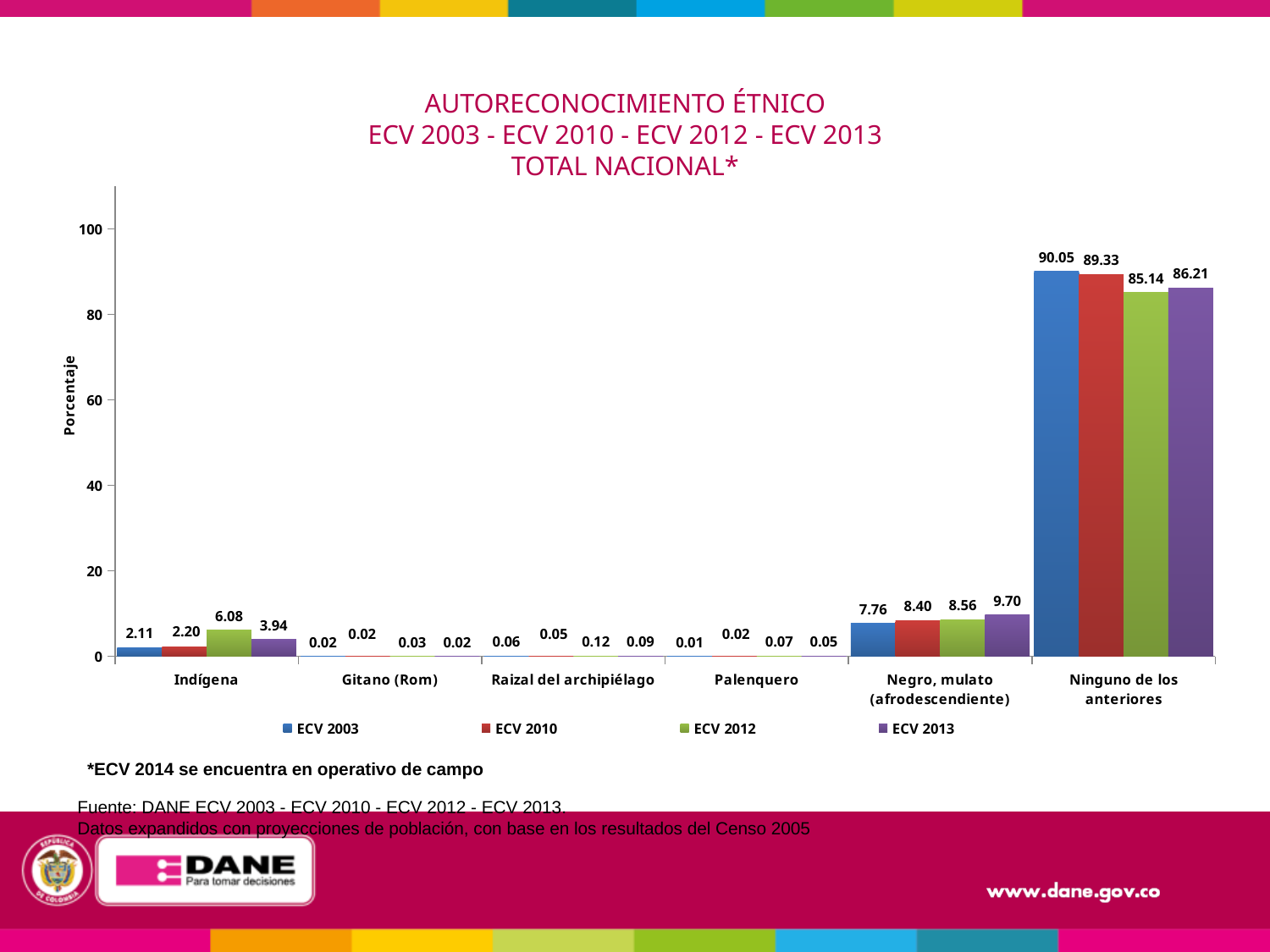
Which category has the lowest value in the ECV 2003 series? Palenquero What is the value for Negro, mulato (afrodescendiente) in the ECV 2013 series? 9.70 What is the value for Ninguno de los anteriores in the ECV 2003 series? 90.05 What is the value for Raizal del archipiélago in the ECV 2012 series? 0.12 How many series does the legend list? 4 How many categories are shown on the x axis? 6 Which category has the highest value in the ECV 2010 series? Ninguno de los anteriores What kind of chart is shown on the slide? Bar chart What is the value for Indígena in the ECV 2012 series? 6.08 What is the difference between the ECV 2003 and ECV 2013 values for Ninguno de los anteriores? 3.84 What is the label of the y axis? Porcentaje Which is larger for Indígena: the ECV 2012 value or the ECV 2013 value? ECV 2012